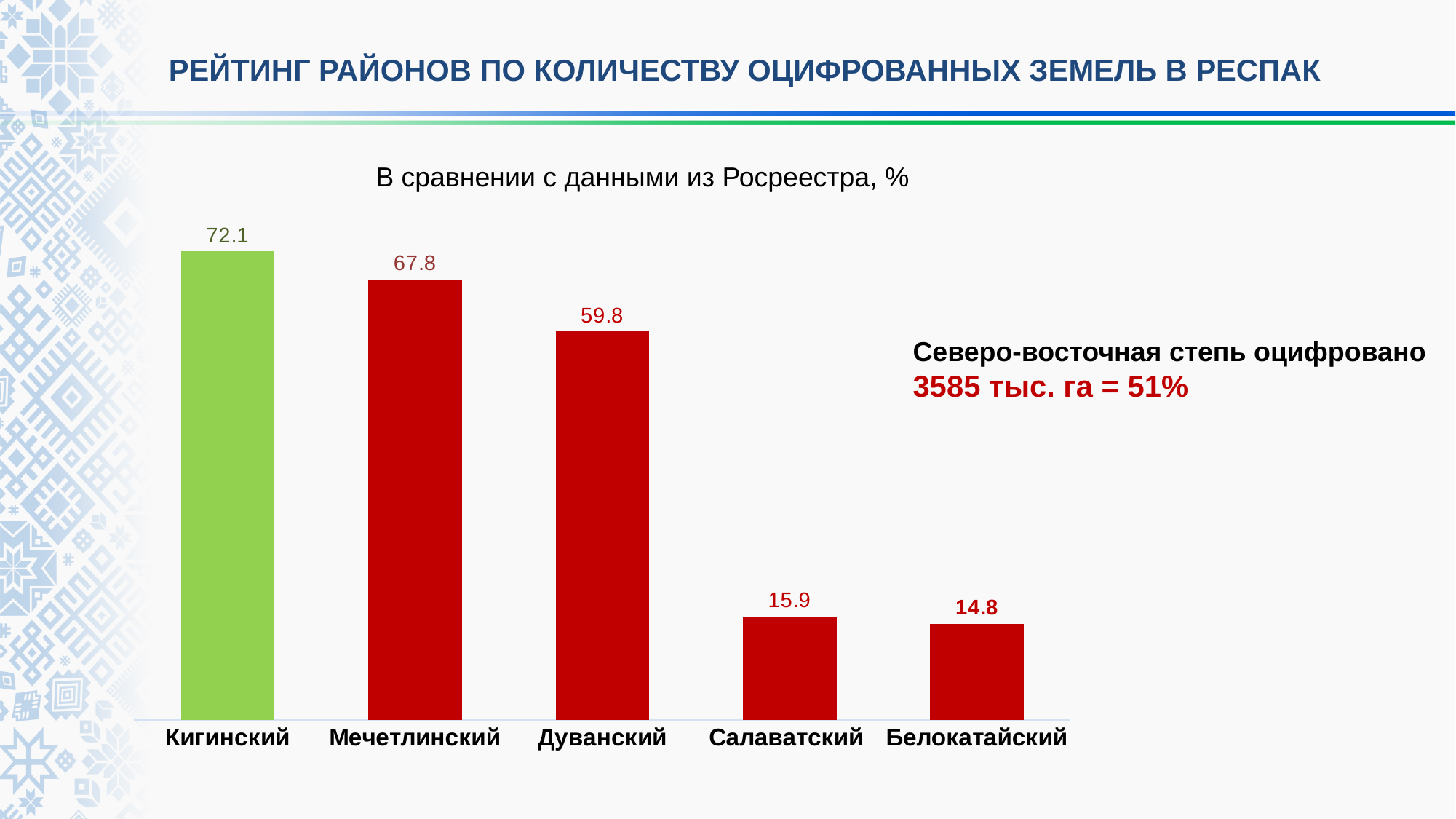
What is the value for Кигинский? 72.1 Which is larger, the value for Мечетлинский or the value for Дуванский? Мечетлинский What is the difference between the values for Кигинский and Мечетлинский? 4.3 Which district has the lowest value? Белокатайский Do the values rise or fall from left to right along the x axis? Fall What is the value for Дуванский? 59.8 What is the difference between the values for Дуванский and Салаватский? 43.9 How many districts are shown in the chart? 5 Which district's bar is coloured green rather than red? Кигинский What is the value for Белокатайский? 14.8 What kind of chart is shown on the slide? Bar chart Which district has the highest value? Кигинский